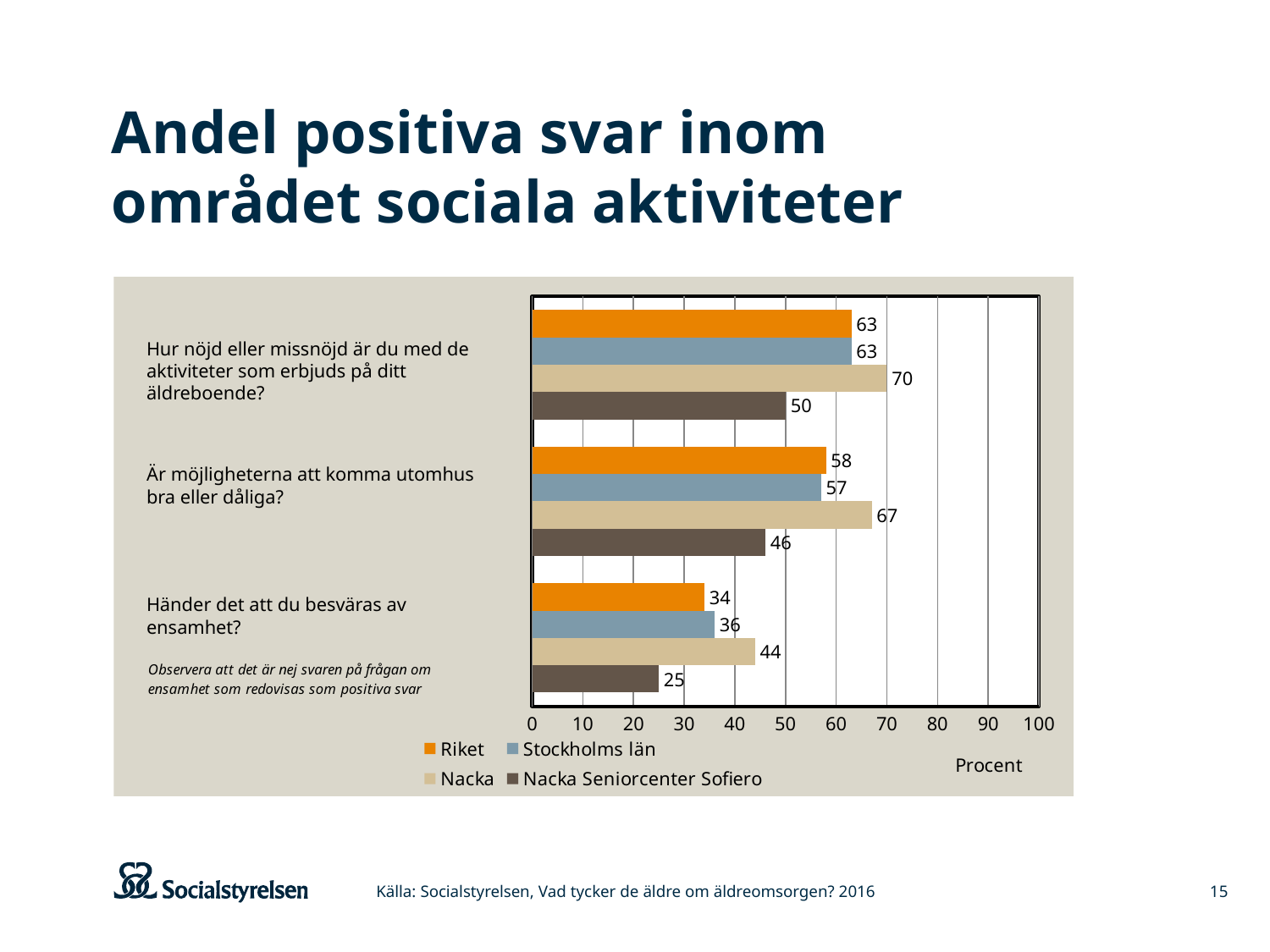
What is the value for Nacka Seniorcenter Sofiero on the question "Är möjligheterna att komma utomhus bra eller dåliga?"? 46 How many question categories are plotted on the chart? 3 What is the difference between the Nacka value and the Nacka Seniorcenter Sofiero value on the question "Hur nöjd eller missnöjd är du med de aktiviteter som erbjuds på ditt äldreboende?"? 20 Which is larger on the question "Händer det att du besväras av ensamhet?": the value for Riket or the value for Stockholms län? Stockholms län How many series does the legend list? 4 What label is shown on the horizontal axis of the chart? Procent Is the value for Nacka Seniorcenter Sofiero on the question "Händer det att du besväras av ensamhet?" greater or less than 30? less Which series has the highest value on the question "Är möjligheterna att komma utomhus bra eller dåliga?"? Nacka What is the value for Riket on the question "Händer det att du besväras av ensamhet?"? 34 What kind of chart is shown on the slide? Bar chart Which series has the lowest value on the question "Händer det att du besväras av ensamhet?"? Nacka Seniorcenter Sofiero What is the value for Nacka on the question "Hur nöjd eller missnöjd är du med de aktiviteter som erbjuds på ditt äldreboende?"? 70